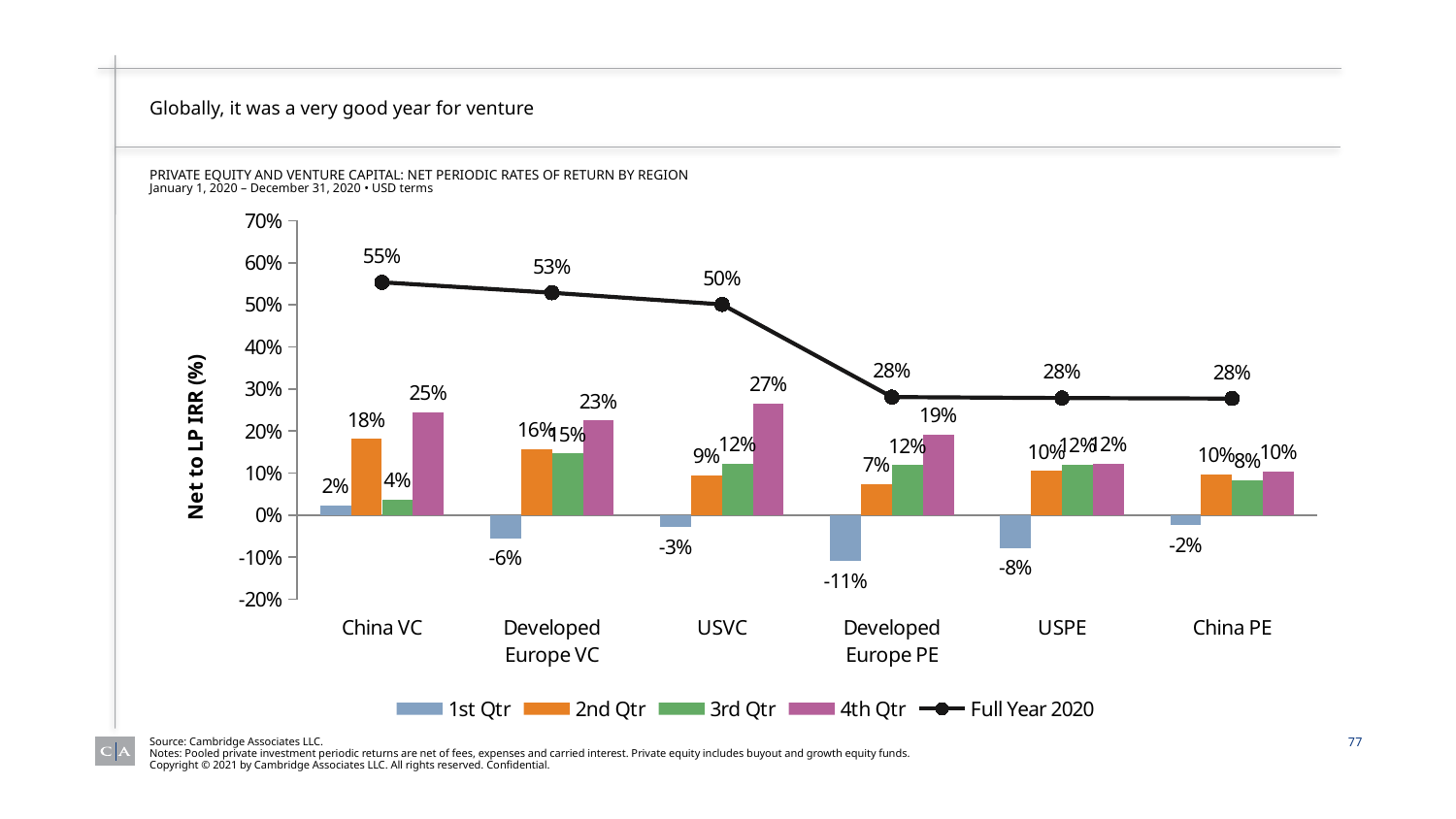
What is the 4th Qtr value for USVC? 27% How many series does the legend list? 5 Which category has the highest Full Year 2020 value? China VC Which category has the lowest 1st Qtr value? Developed Europe PE How many categories are shown on the x axis? 6 What is the Full Year 2020 value for China VC? 55% What is the 2nd Qtr value for Developed Europe VC? 16% Does the Full Year 2020 line rise or fall from China VC to Developed Europe PE? Fall What kind of chart is this? Combined bar and line chart What is the 1st Qtr value for Developed Europe PE? -11% Which is larger, the 4th Qtr value for China VC or the 4th Qtr value for Developed Europe VC? China VC What is the difference between the Full Year 2020 values for China VC and USVC? 5%